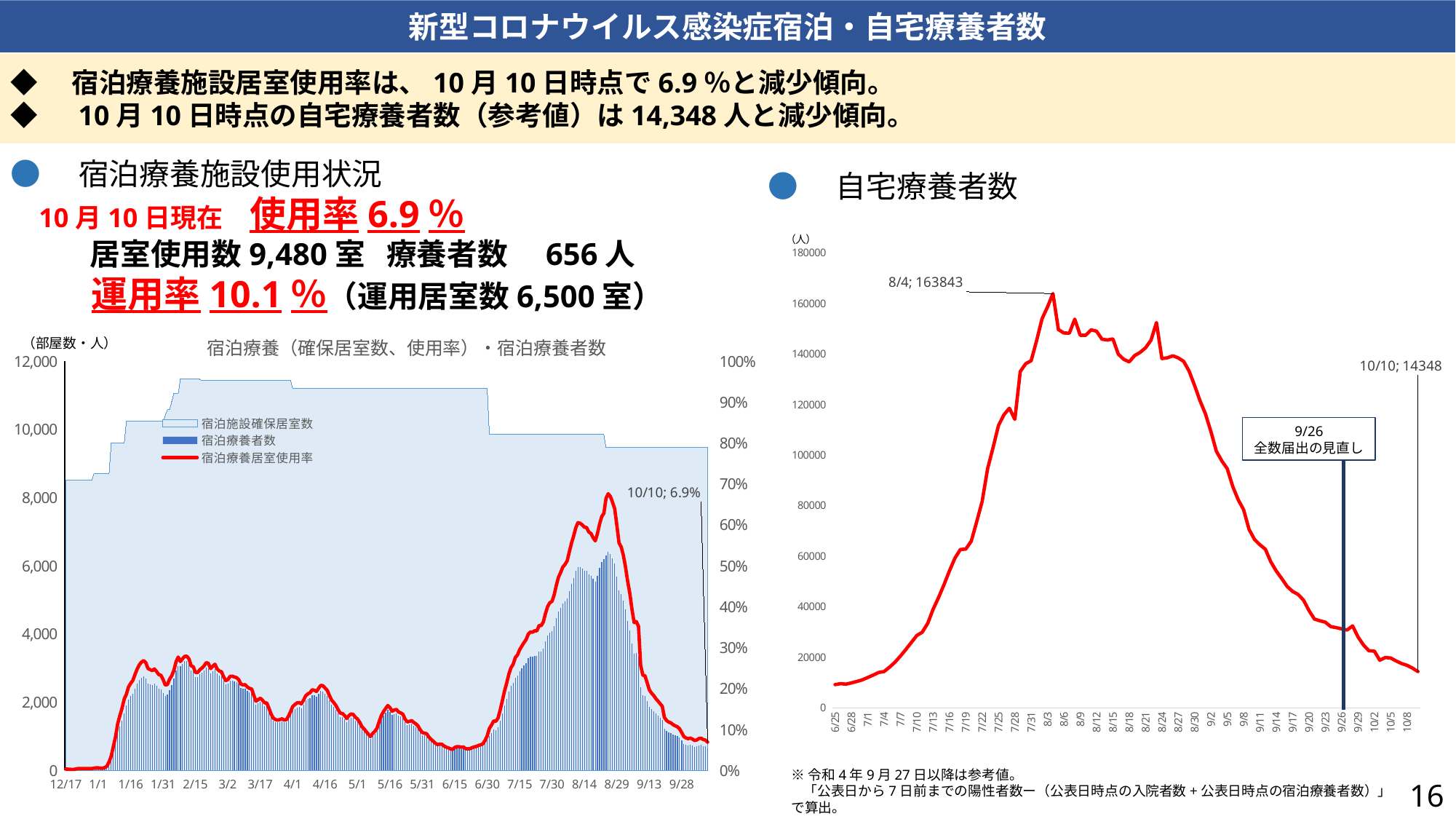
What kind of chart is the 自宅療養者数 chart on the right? line chart In the 自宅療養者数 chart on the right, what event is annotated at 9/26? 全数届出の見直し In the 自宅療養者数 chart on the right, on which date does the line reach its peak? 8/4 How many series does the legend of the left chart (宿泊療養（確保居室数、使用率）・宿泊療養者数) list? 3 In the 自宅療養者数 chart on the right, is the value for 7/1 greater or less than 20000? less In the left chart (宿泊療養（確保居室数、使用率）・宿泊療養者数), is the peak of the 宿泊療養居室使用率 line greater or less than 60%? greater In the 自宅療養者数 chart on the right, what is the highest value shown on the line? 163843 In the left chart (宿泊療養（確保居室数、使用率）・宿泊療養者数), what is the 宿泊療養居室使用率 labelled for 10/10? 6.9% In the 自宅療養者数 chart on the right, is the value for 9/26 greater or less than 20000? greater In the 自宅療養者数 chart on the right, what is the value labelled for 10/10? 14348 In the 自宅療養者数 chart on the right, does the line rise or fall between 8/4 and 10/10? fall In the 自宅療養者数 chart on the right, what is the difference between the 8/4 value and the 10/10 value? 149495